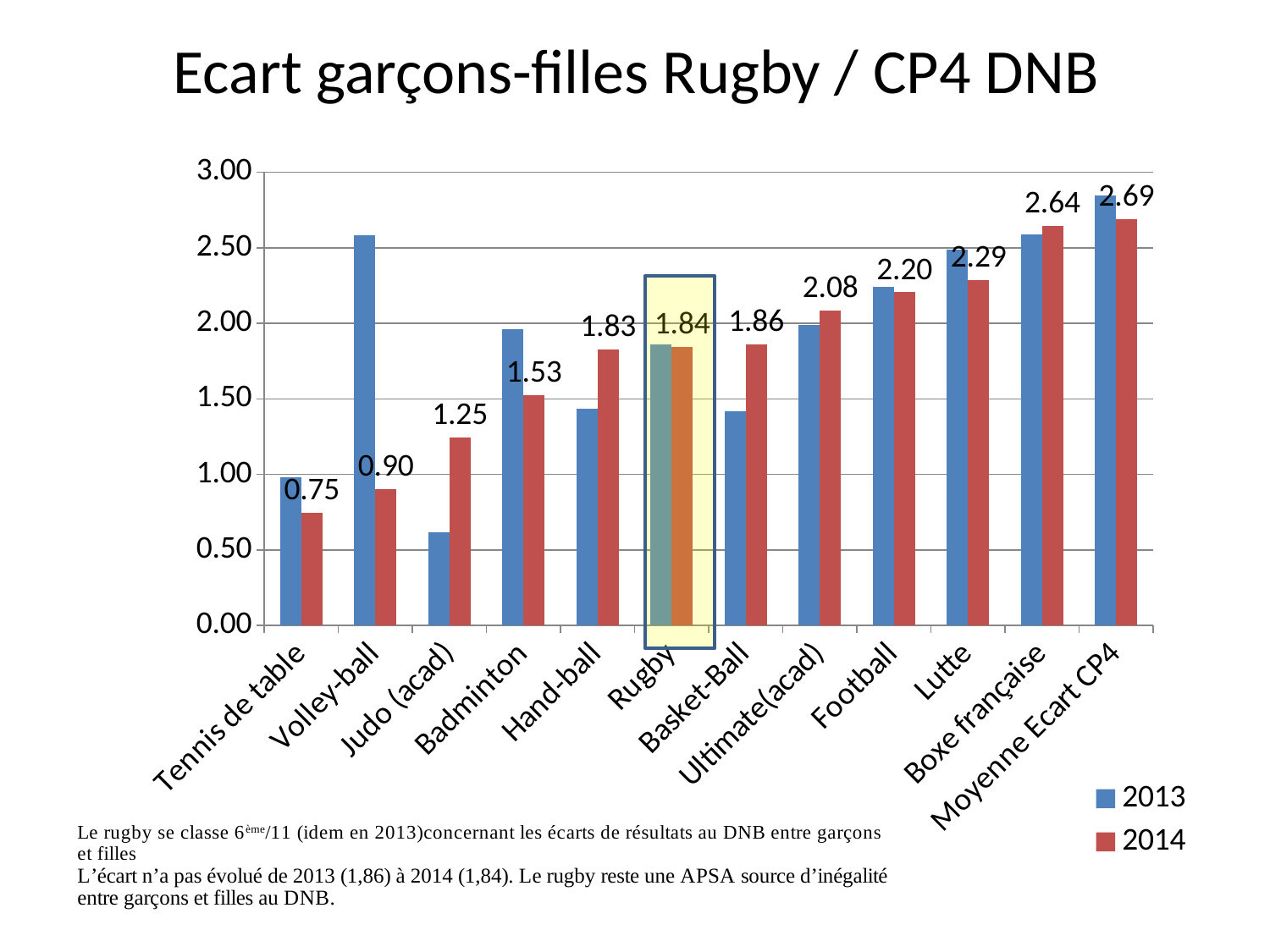
Is the 2013 value for Judo (acad) greater or less than 1.00? less What is the 2014 value for Tennis de table? 0.75 What is the 2014 value for Boxe française? 2.64 Which category has the lowest 2014 value? Tennis de table What kind of chart is shown on the slide? bar chart What is the difference between the 2014 values for Boxe française and Rugby? 0.80 What is the 2014 value for Rugby? 1.84 Which category has the highest 2014 value? Moyenne Ecart CP4 How many categories are shown on the x axis? 12 Which has the larger 2014 value, Football or Lutte? Lutte Is the 2013 value for Volley-ball greater or less than 2.50? greater How many series does the legend list? 2